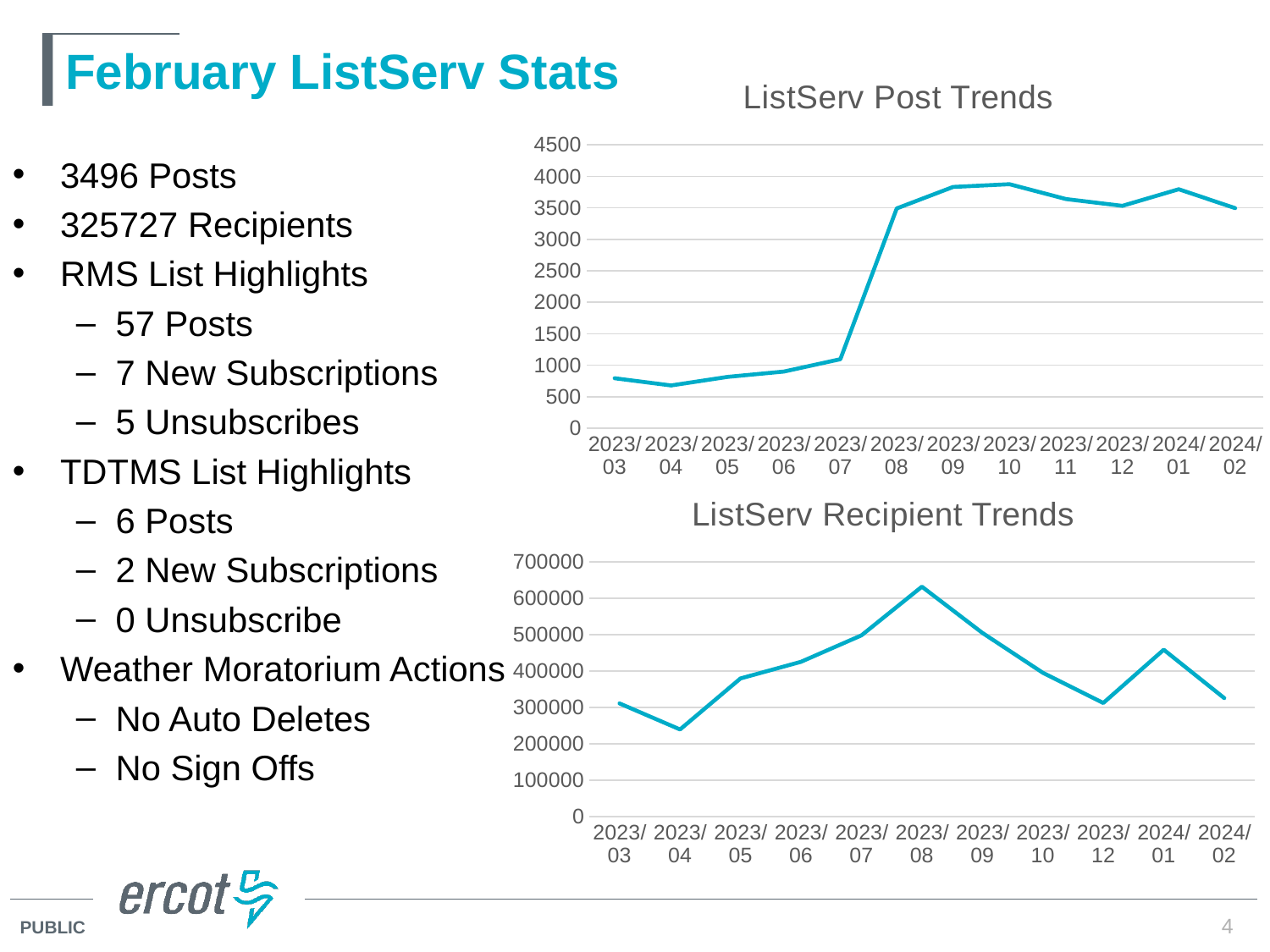
On the ListServ Post Trends chart, is the value for 2023/08 greater or less than 3000? greater On the ListServ Recipient Trends chart, which month has the lowest value? 2023/04 On the ListServ Recipient Trends chart, which is larger, the value for 2023/08 or the value for 2024/01? 2023/08 On the ListServ Recipient Trends chart, which month has the highest value? 2023/08 On the ListServ Post Trends chart, which month has the lowest value? 2023/04 How many data points are plotted on the ListServ Recipient Trends chart? 11 On the ListServ Post Trends chart, which is larger, the value for 2023/07 or the value for 2023/08? 2023/08 What kind of chart is the ListServ Post Trends chart? line chart On the ListServ Post Trends chart, is the value for 2023/03 greater or less than 1000? less What is the title of the lower chart on the slide? ListServ Recipient Trends On the ListServ Recipient Trends chart, is the value for 2023/04 greater or less than 300000? less How many data points are plotted on the ListServ Post Trends chart? 12